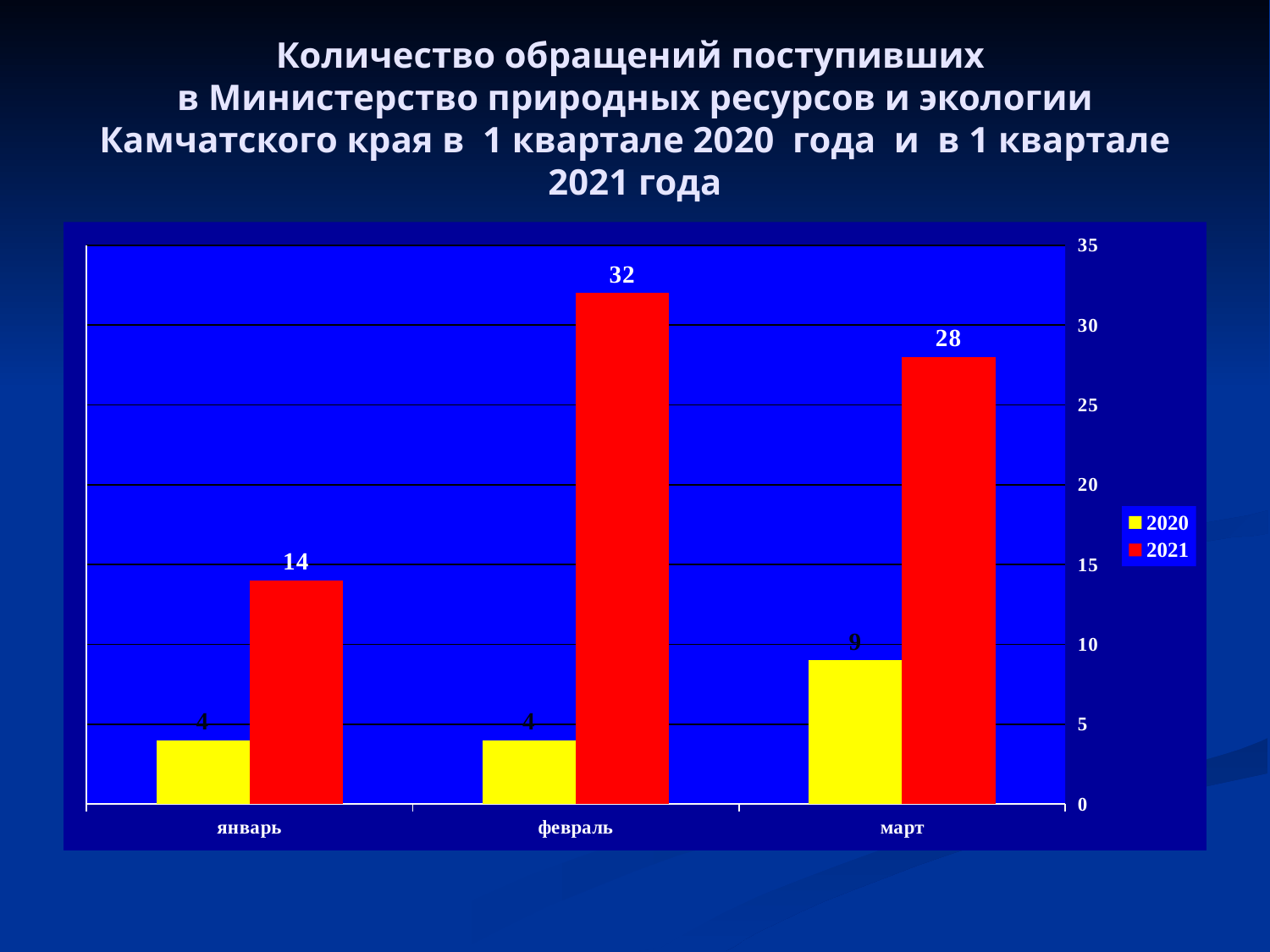
What is the value for 2021 in январь? 14 What is the value for 2020 in март? 9 Which month has the highest value for the 2020 series? март What is the difference between the 2021 and 2020 values in март? 19 What is the value for 2020 in январь? 4 How many series does the legend list? 2 What kind of chart is shown on the slide? bar chart What is the difference between the 2021 values for февраль and январь? 18 Which month has the highest value for the 2021 series? февраль What is the value for 2021 in февраль? 32 Which is larger in февраль: the 2020 value or the 2021 value? 2021 How many months are shown on the x axis? 3